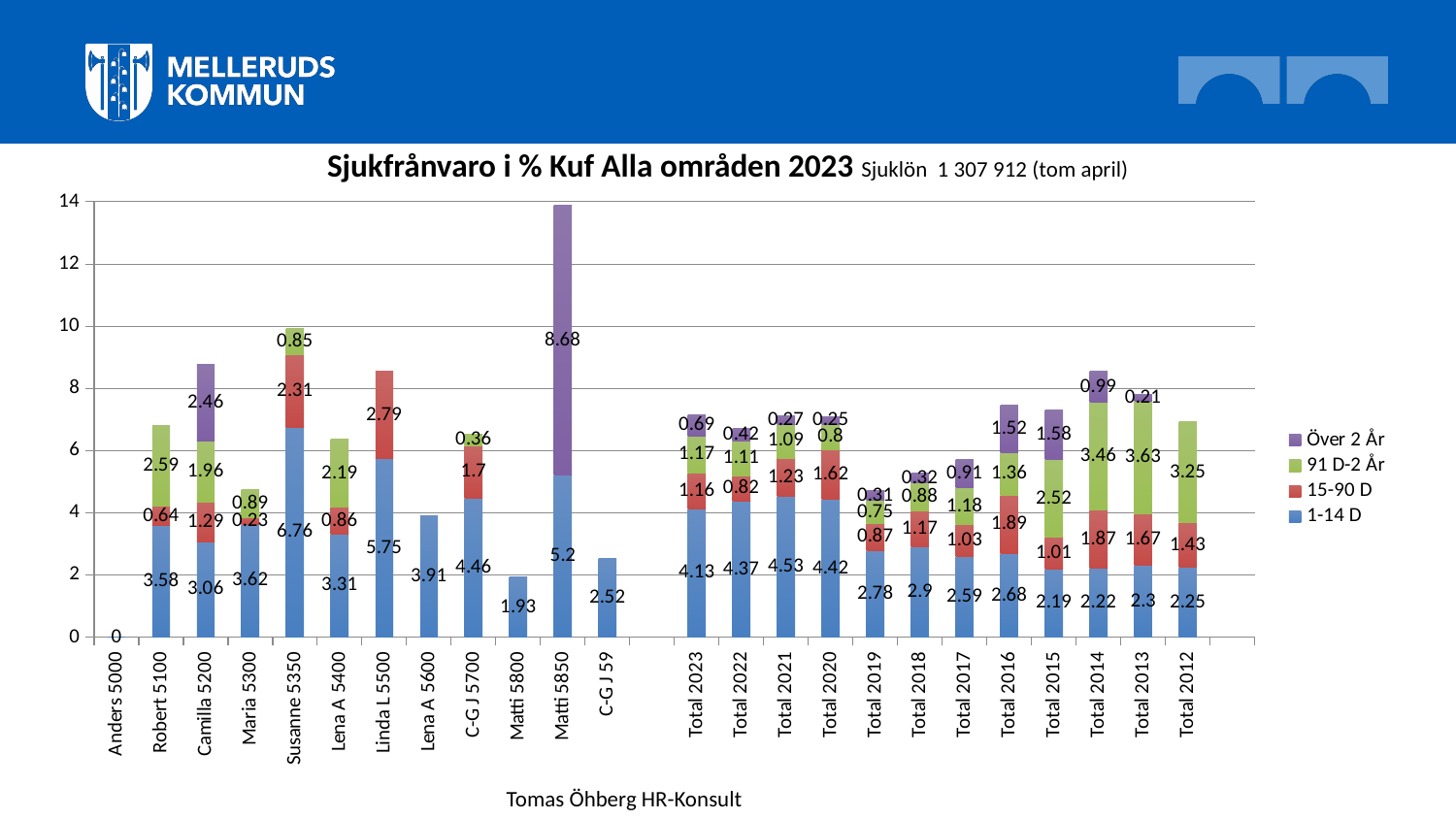
What is the difference between the 1-14 D values for Total 2021 and Total 2023? 0.4 Which has the larger 91 D-2 År value, Total 2013 or Total 2014? Total 2013 What is the 1-14 D value for Susanne 5350? 6.76 What is the Över 2 År value for Matti 5850? 8.68 How many series does the legend list? 4 What kind of chart is shown on the slide? Stacked bar chart What is the 15-90 D value for Linda L 5500? 2.79 Which category has the tallest stacked bar? Matti 5850 What is the total of the stacked bar for Robert 5100? 6.81 Is the total of the stacked bar for Camilla 5200 greater or less than 8? greater What is the total of the stacked bar for Matti 5850? 13.88 Which category has the lowest total, with a value of 0? Anders 5000